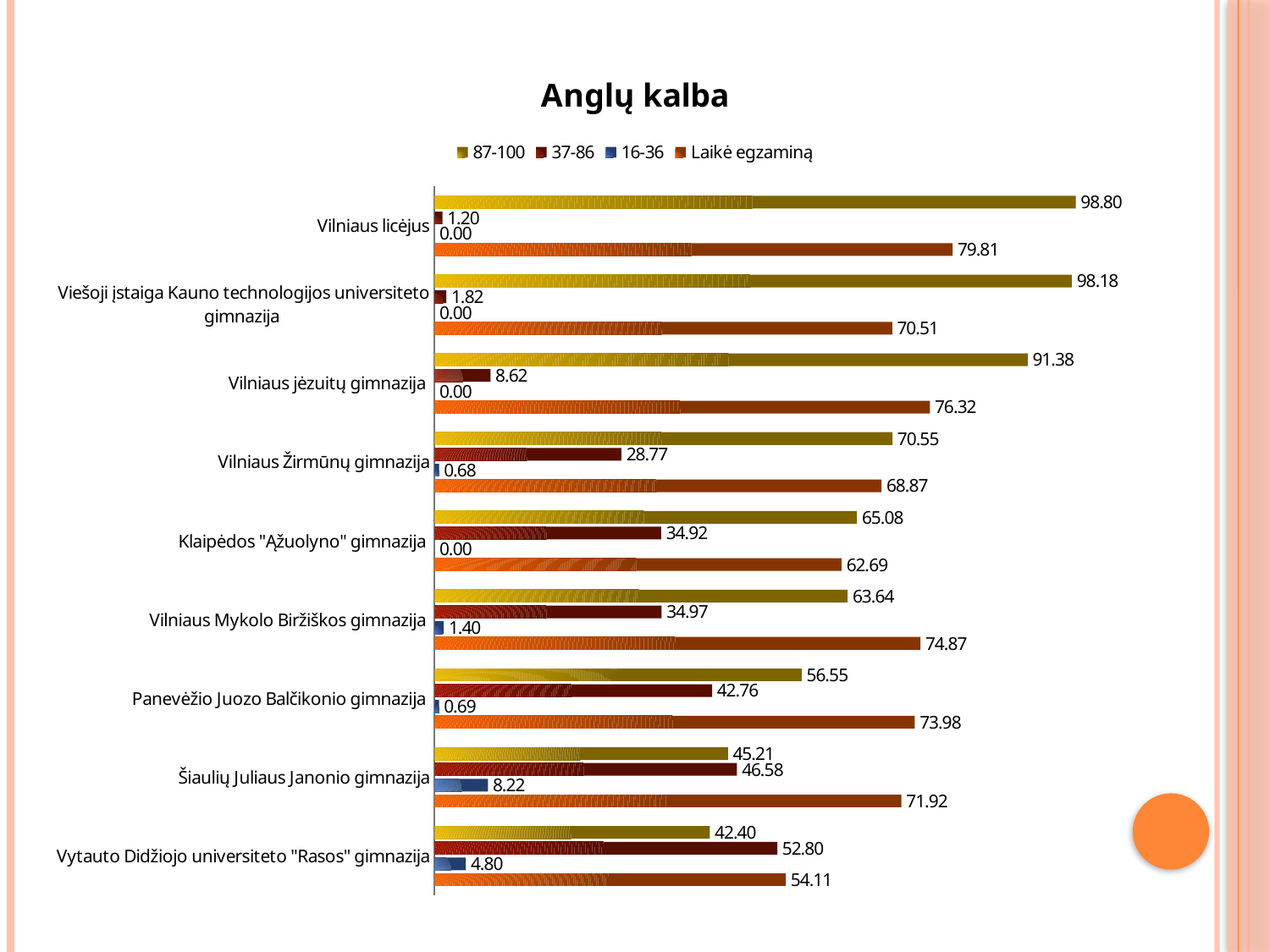
Which is larger for Panevėžio Juozo Balčikonio gimnazija: the 87-100 value or the 37-86 value? 87-100 What is the title of the chart? Anglų kalba What is the Laikė egzaminą value for Vilniaus jėzuitų gimnazija? 76.32 What is the 37-86 value for Šiaulių Juliaus Janonio gimnazija? 46.58 How many schools are shown on the chart? 9 What is the value of the 87-100 series for Vilniaus licėjus? 98.80 What is the difference between the 87-100 values of Vilniaus licėjus and Vilniaus jėzuitų gimnazija? 7.42 Which school has the highest value in the 87-100 series? Vilniaus licėjus What type of chart is shown on the slide? Bar chart Which school has the lowest Laikė egzaminą value? Vytauto Didžiojo universiteto "Rasos" gimnazija What is the 16-36 value for Vytauto Didžiojo universiteto "Rasos" gimnazija? 4.80 How many series does the legend list? 4